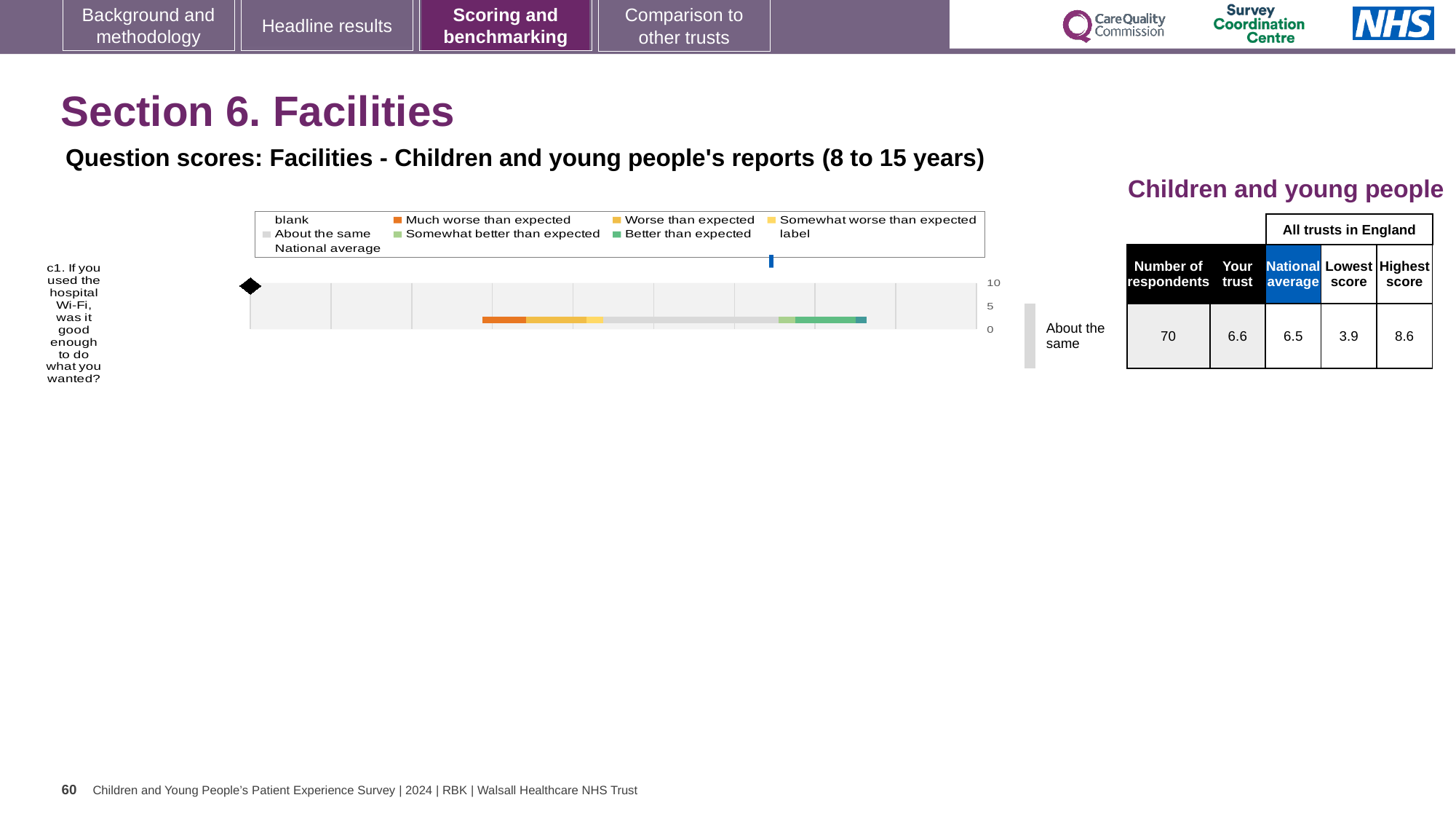
Is the 'Your trust' score for question c1 higher or lower than the national average? higher What kind of chart is shown for question c1 on the slide? bar chart According to the table next to the chart, what is the highest score among all trusts in England for question c1? 8.6 According to the table next to the chart, what is the lowest score among all trusts in England for question c1? 3.9 Which legend entry is shown in orange in the chart? Much worse than expected According to the table next to the chart, what is the national average score for question c1? 6.5 How many survey questions (categories) are plotted in the chart? 1 What is the difference between the highest score and the lowest score for question c1 in the table next to the chart? 4.7 What benchmark category is the trust's result for question c1 assigned to? About the same Which question is plotted in the chart? c1. If you used the hospital Wi-Fi, was it good enough to do what you wanted? According to the table next to the chart, what is the 'Your trust' score for question c1? 6.6 How many respondents answered question c1, according to the table next to the chart? 70